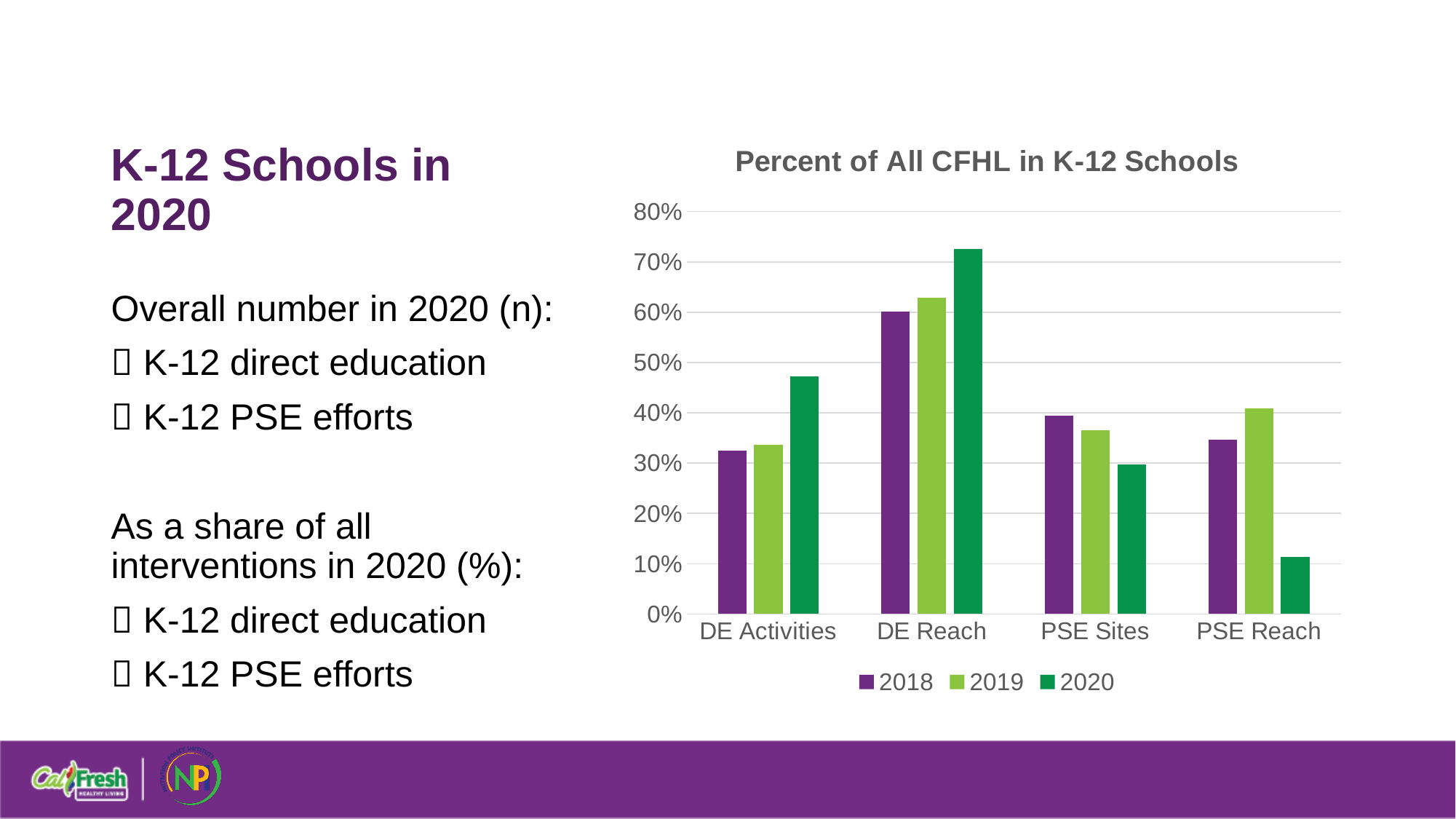
Is the 2018 value for PSE Sites greater or less than 50%? less Is the 2020 value for DE Activities greater or less than 40%? greater Which category has the lowest 2020 value? PSE Reach Is the 2020 value for DE Reach greater or less than 60%? greater How many categories are shown on the x axis of the chart? 4 What is the title of the chart? Percent of All CFHL in K-12 Schools What kind of chart is shown on the slide? bar chart How many series does the chart's legend list? 3 Which is larger for 2020: DE Activities or PSE Sites? DE Activities For PSE Sites, do the values rise or fall from 2018 to 2020? fall Which category has the highest 2020 value? DE Reach